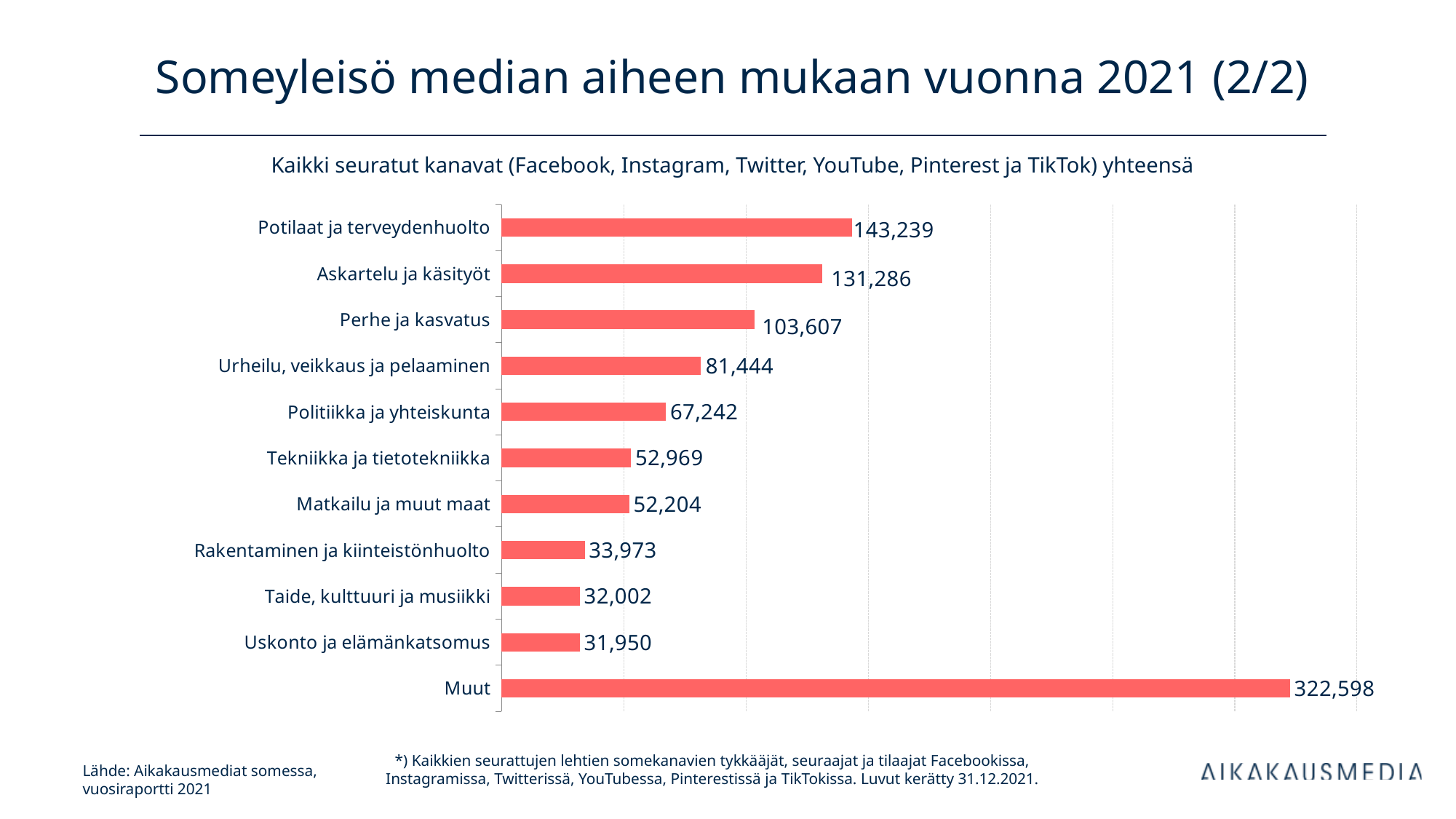
What is the difference between Potilaat ja terveydenhuolto and Askartelu ja käsityöt? 11,953 What is the value for Potilaat ja terveydenhuolto? 143,239 Which category has the highest value? Muut What is the value for Uskonto ja elämänkatsomus? 31,950 What is the subtitle shown above the chart? Kaikki seuratut kanavat (Facebook, Instagram, Twitter, YouTube, Pinterest ja TikTok) yhteensä Which is larger, Rakentaminen ja kiinteistönhuolto or Taide, kulttuuri ja musiikki? Rakentaminen ja kiinteistönhuolto What is the value for Perhe ja kasvatus? 103,607 How many categories are shown in the chart? 11 What kind of chart is shown on the slide? Bar chart Which category has the lowest value? Uskonto ja elämänkatsomus What is the value for Muut? 322,598 What is the difference between Tekniikka ja tietotekniikka and Matkailu ja muut maat? 765